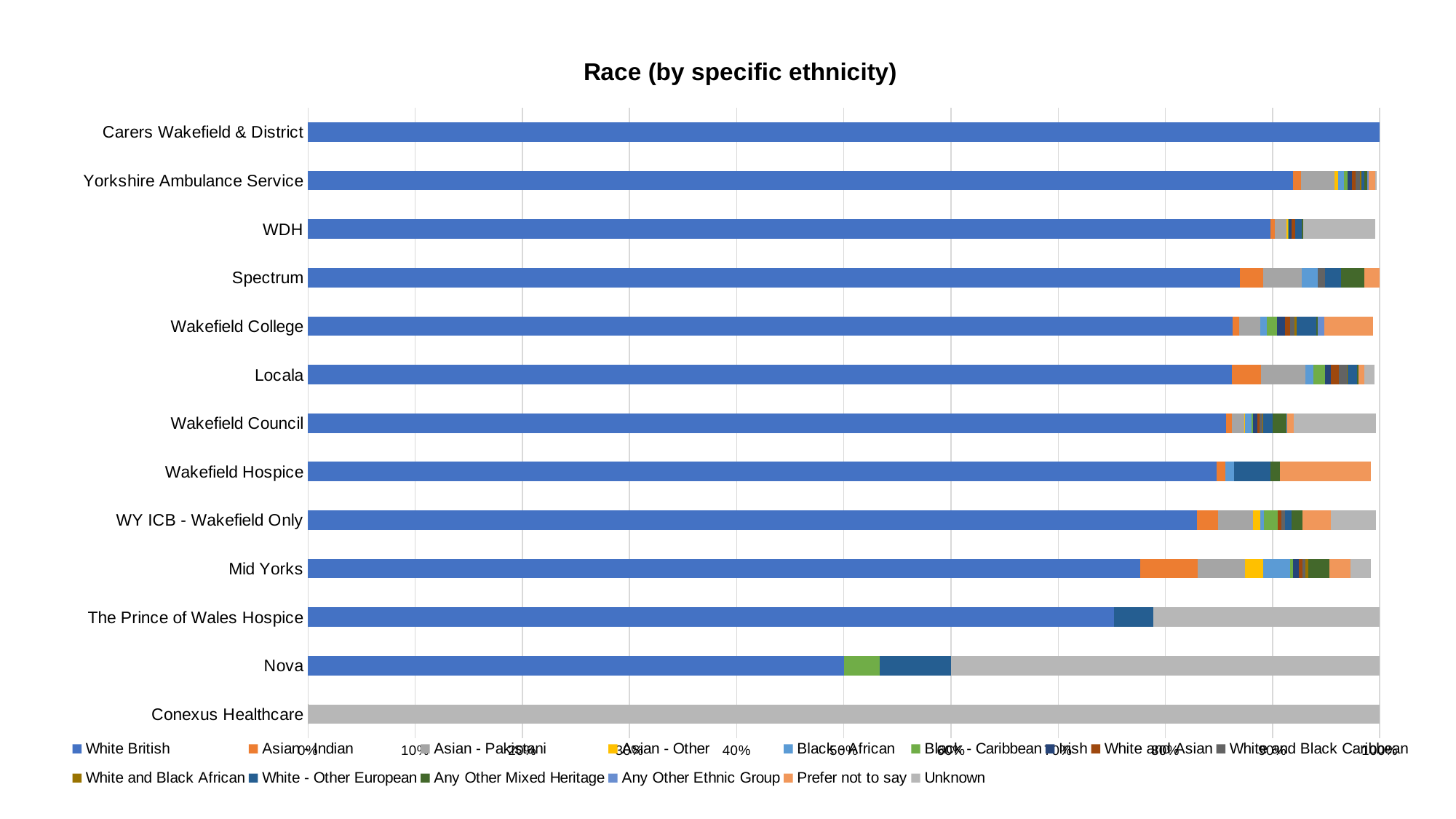
Is the Unknown share for Conexus Healthcare greater or less than 90%? greater Which organisation has the smallest White British share? Conexus Healthcare How many organisations are listed on the vertical axis of the chart? 13 What is the title of the chart? Race (by specific ethnicity) What type of chart is shown on the slide? Stacked bar chart How many series does the chart legend list? 15 Is the White British share for Mid Yorks greater or less than 80%? less Is the White British share for The Prince of Wales Hospice greater or less than 70%? greater Which organisation has the largest Unknown share? Conexus Healthcare Which has the larger White British share, Nova or The Prince of Wales Hospice? The Prince of Wales Hospice